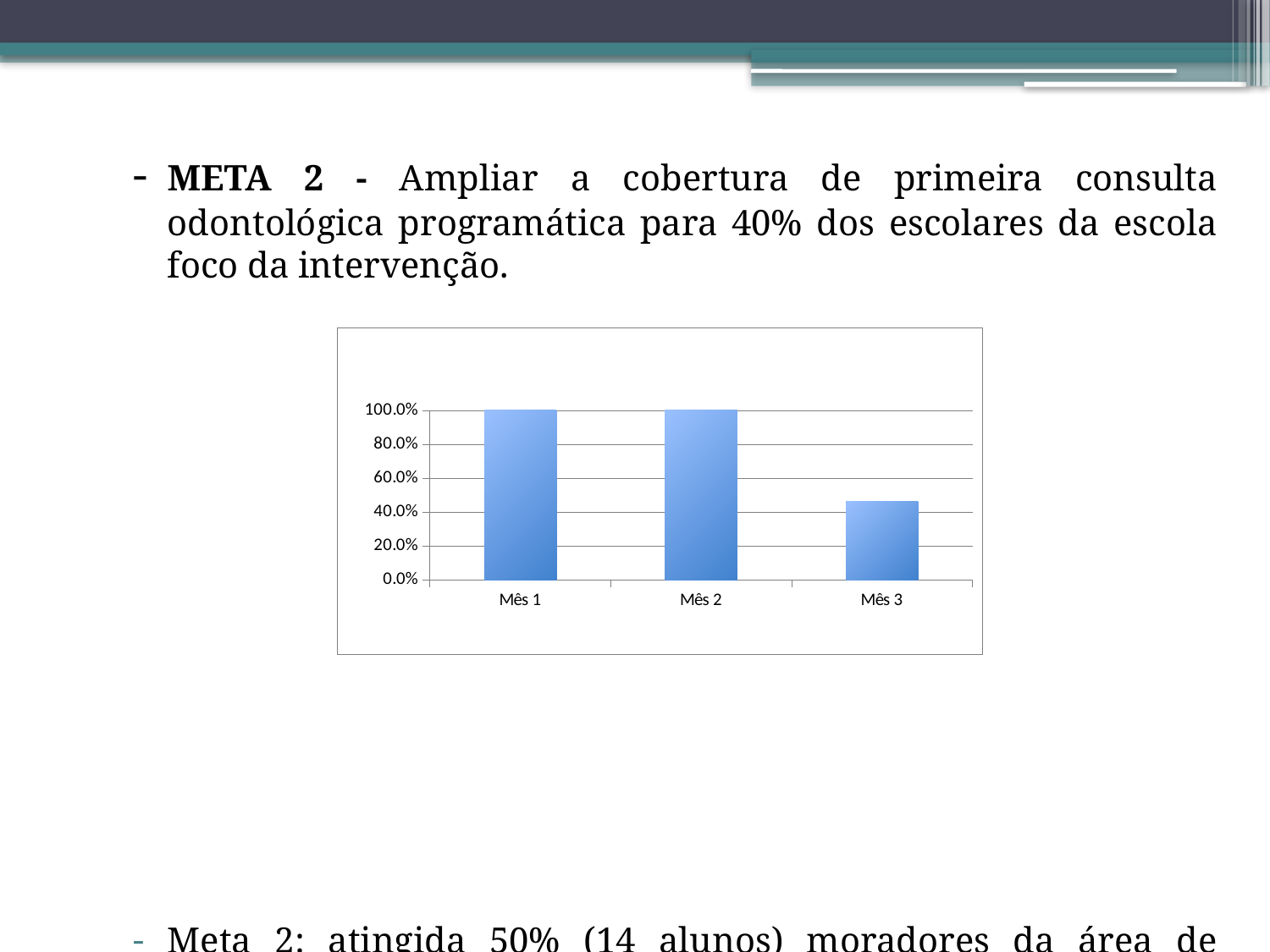
Is the value for Mês 3 greater or less than 40.0%? greater Which is larger, the value for Mês 1 or the value for Mês 3? Mês 1 Is the value for Mês 3 greater or less than 60.0%? less How many categories are shown on the x axis of the chart? 3 What is the value for Mês 1 in the chart? 100.0% Do the values rise or fall from Mês 2 to Mês 3? fall What is the highest tick label shown on the vertical axis of the chart? 100.0% What is the value for Mês 2 in the chart? 100.0% Which category has the lowest value in the chart? Mês 3 What kind of chart is shown on the slide? bar chart What colour are the bars in the chart? blue